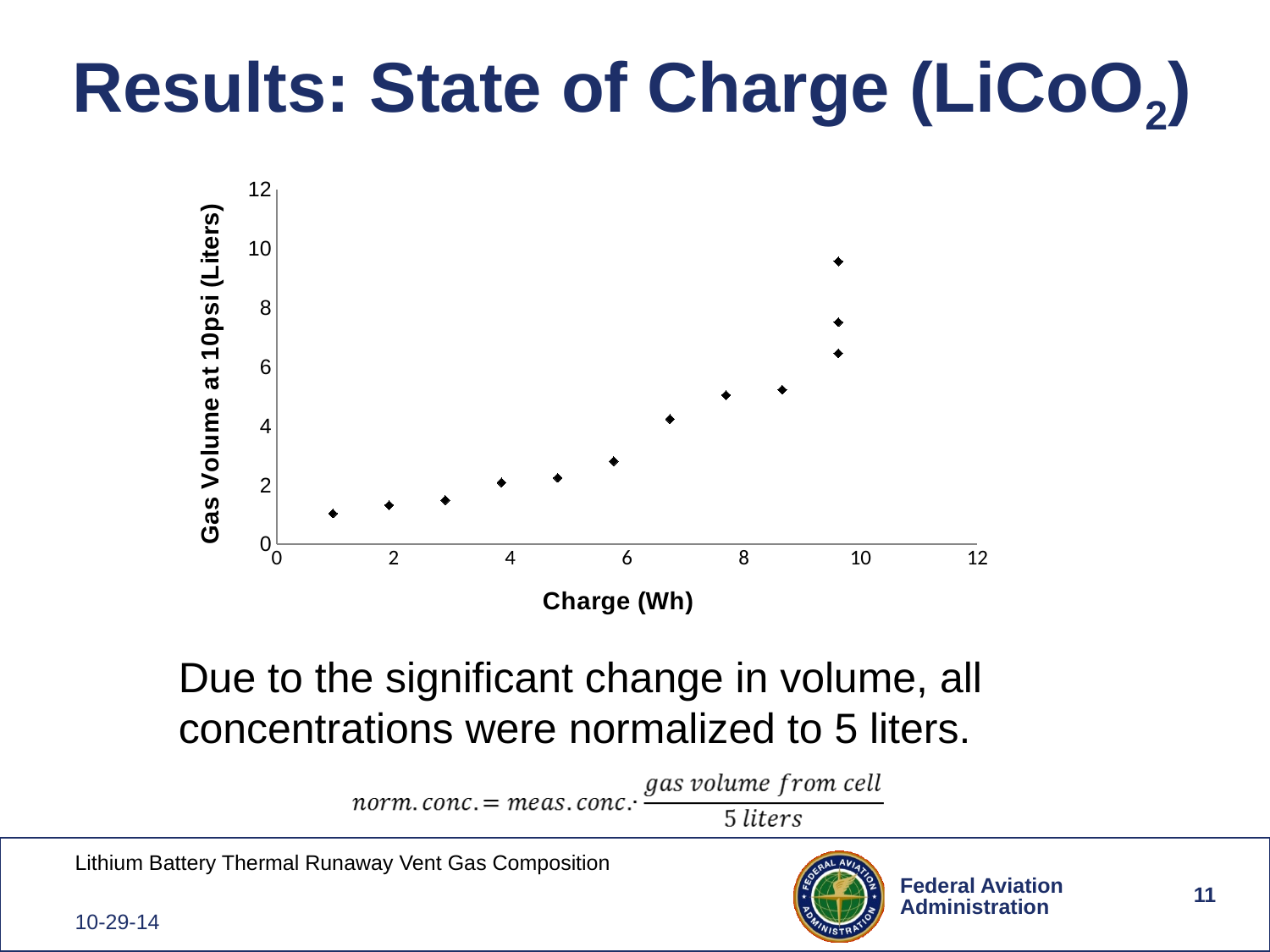
Which has the larger gas volume: the point near 2 Wh or the point near 8 Wh? The point near 8 Wh What is the label of the x axis? Charge (Wh) Is the highest plotted gas volume greater or less than 10 liters? less Do the gas volume values generally rise or fall as charge increases along the x axis? Rise How many data points are plotted on the chart? 12 Is the highest plotted gas volume greater or less than 8 liters? greater Is the gas volume for the point near 8 Wh greater or less than 4 liters? greater What is the label of the y axis? Gas Volume at 10psi (Liters) What kind of chart is shown on the slide? Scatter plot